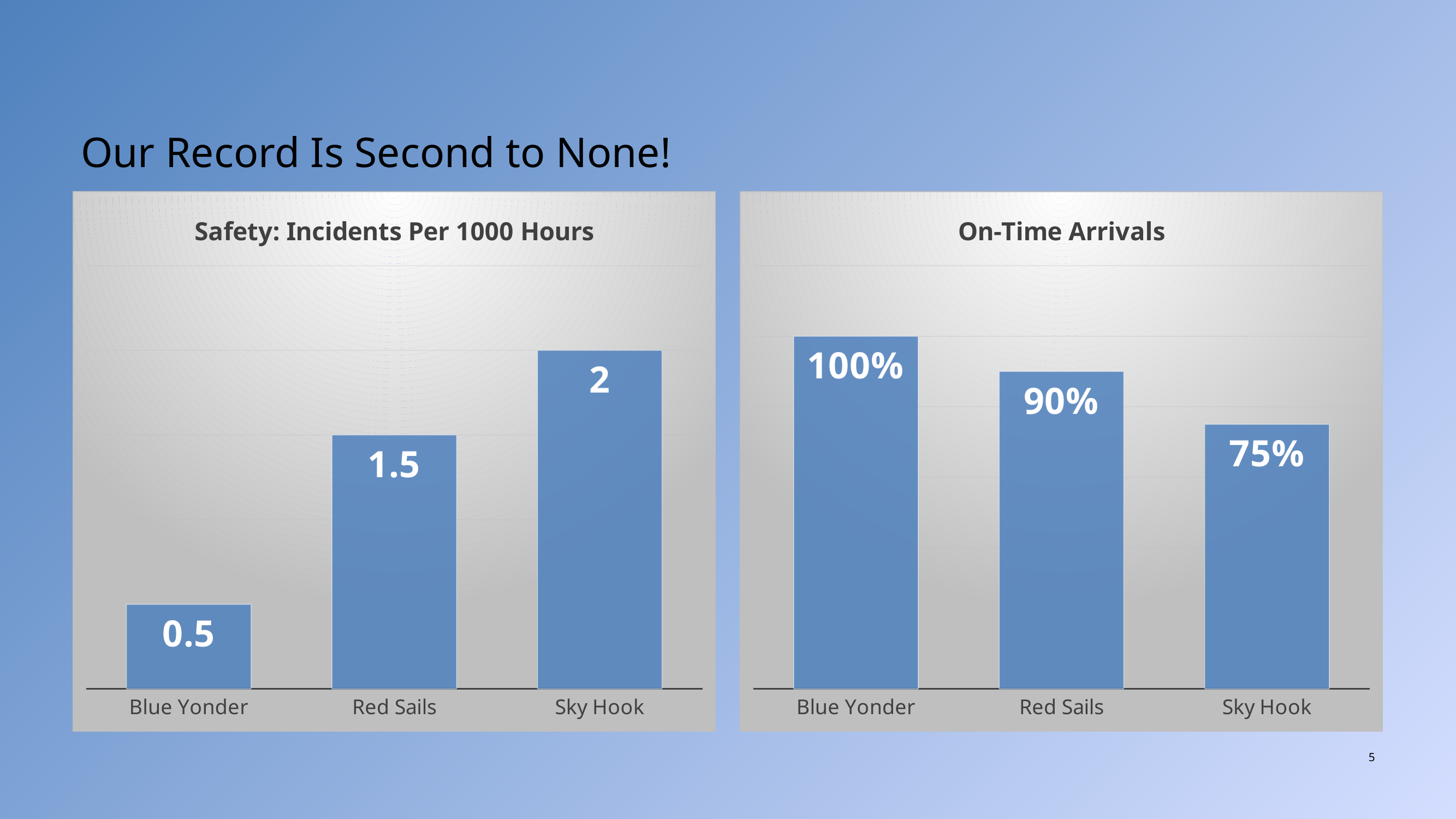
In the 'On-Time Arrivals' chart, which is larger, the value for Red Sails or the value for Sky Hook? Red Sails In the 'Safety: Incidents Per 1000 Hours' chart, what is the value for Red Sails? 1.5 In the 'Safety: Incidents Per 1000 Hours' chart, which category has the lowest value? Blue Yonder In the 'Safety: Incidents Per 1000 Hours' chart, what is the difference between the values for Sky Hook and Blue Yonder? 1.5 In the 'Safety: Incidents Per 1000 Hours' chart, what is the value for Blue Yonder? 0.5 How many categories are shown in the 'On-Time Arrivals' chart? 3 In the 'Safety: Incidents Per 1000 Hours' chart, do the values rise or fall from Blue Yonder to Sky Hook? rise In the 'On-Time Arrivals' chart, what is the difference between the values for Blue Yonder and Red Sails? 10% In the 'On-Time Arrivals' chart, what is the value for Red Sails? 90% In the 'On-Time Arrivals' chart, what is the value for Sky Hook? 75% In the 'On-Time Arrivals' chart, which category has the highest value? Blue Yonder In the 'Safety: Incidents Per 1000 Hours' chart, which category has the highest value? Sky Hook